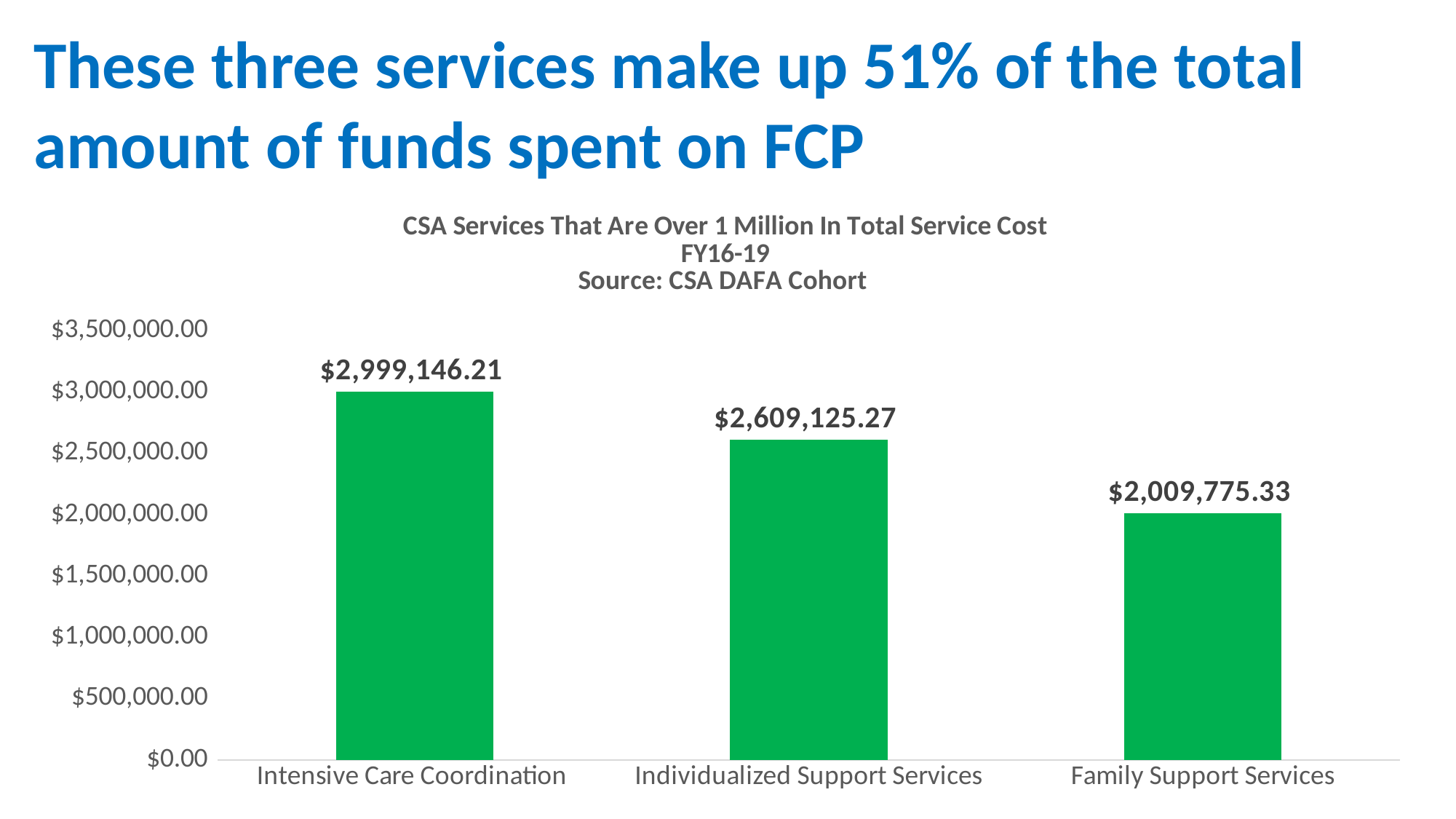
What is the total service cost for Family Support Services? $2,009,775.33 How many services are shown in the chart? 3 What kind of chart is shown on the slide? Bar chart What is the source cited in the chart title? CSA DAFA Cohort What is the total service cost for Individualized Support Services? $2,609,125.27 What is the difference in total service cost between Intensive Care Coordination and Individualized Support Services? $390,020.94 Is the value for Family Support Services greater or less than $2,500,000.00? less Which service has the lowest total service cost? Family Support Services What is the difference in total service cost between Individualized Support Services and Family Support Services? $599,349.94 What is the total service cost for Intensive Care Coordination? $2,999,146.21 Which service has the highest total service cost? Intensive Care Coordination Which has a larger total service cost, Individualized Support Services or Family Support Services? Individualized Support Services